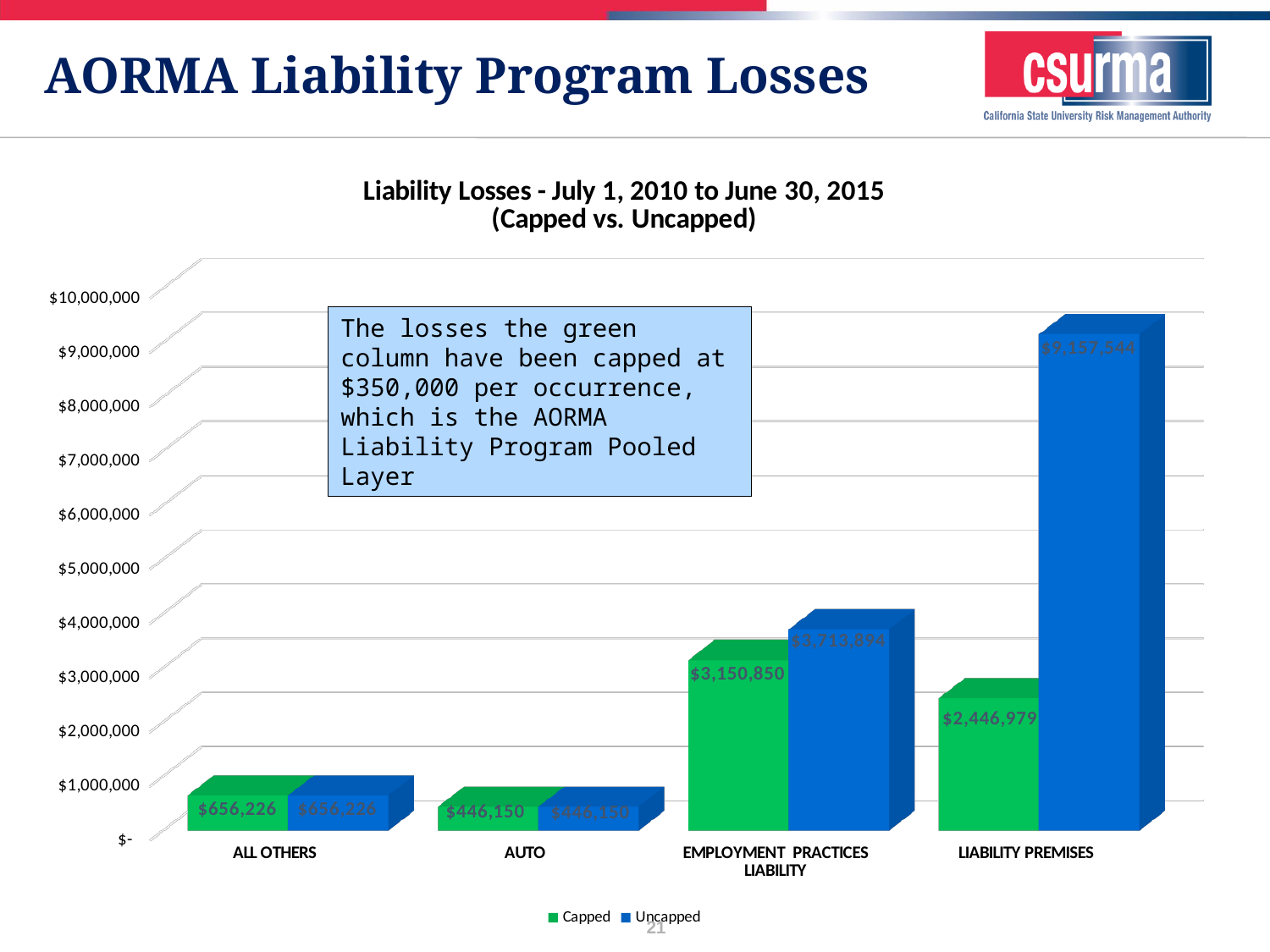
What is the Uncapped value for LIABILITY PREMISES? $9,157,544 Which category has the highest Uncapped value? LIABILITY PREMISES What is the Capped value for AUTO? $446,150 What is the title of the chart? Liability Losses - July 1, 2010 to June 30, 2015 (Capped vs. Uncapped) Which is larger for EMPLOYMENT PRACTICES LIABILITY, the Capped or the Uncapped value? Uncapped What is the Uncapped value for ALL OTHERS? $656,226 How many categories are shown on the x axis? 4 How many series does the legend list? 2 What is the Capped value for EMPLOYMENT PRACTICES LIABILITY? $3,150,850 What kind of chart is shown on the slide? Bar chart What is the difference between the Uncapped and Capped values for LIABILITY PREMISES? $6,710,565 Which category has the lowest Capped value? AUTO